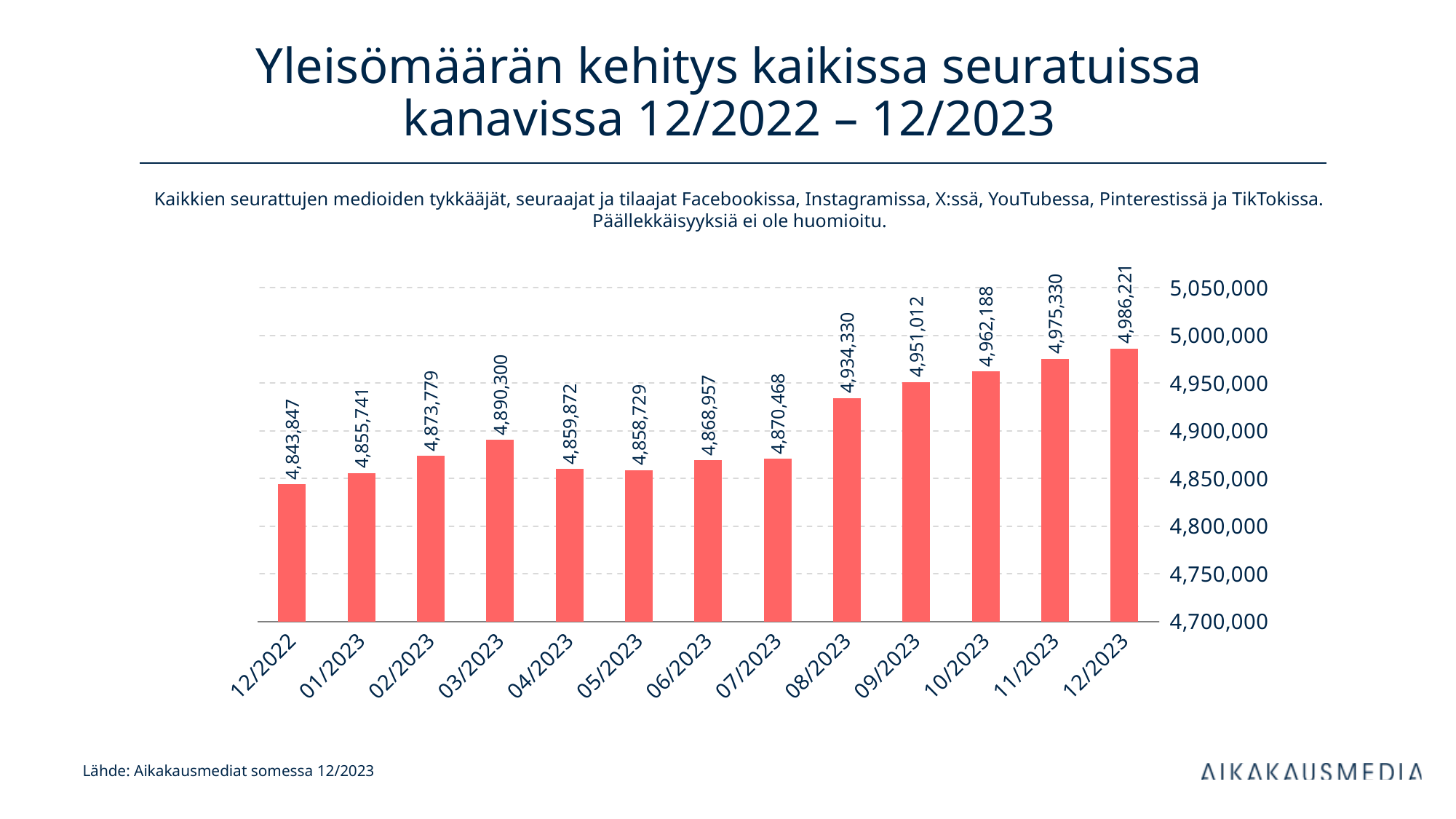
What is the value for 12/2022? 4,843,847 What is the difference between the values for 12/2023 and 12/2022? 142,374 What kind of chart is shown on the slide? bar chart What is the value for 03/2023? 4,890,300 Which month has the lowest value? 12/2022 Which month has the highest value? 12/2023 Is the value for 09/2023 greater or less than 4,900,000? greater How many months are shown on the x axis? 13 What is the value for 08/2023? 4,934,330 What is the difference between the values for 03/2023 and 04/2023? 30,428 Which is larger, the value for 03/2023 or the value for 07/2023? 03/2023 Do the values generally rise or fall from 12/2022 to 12/2023? rise